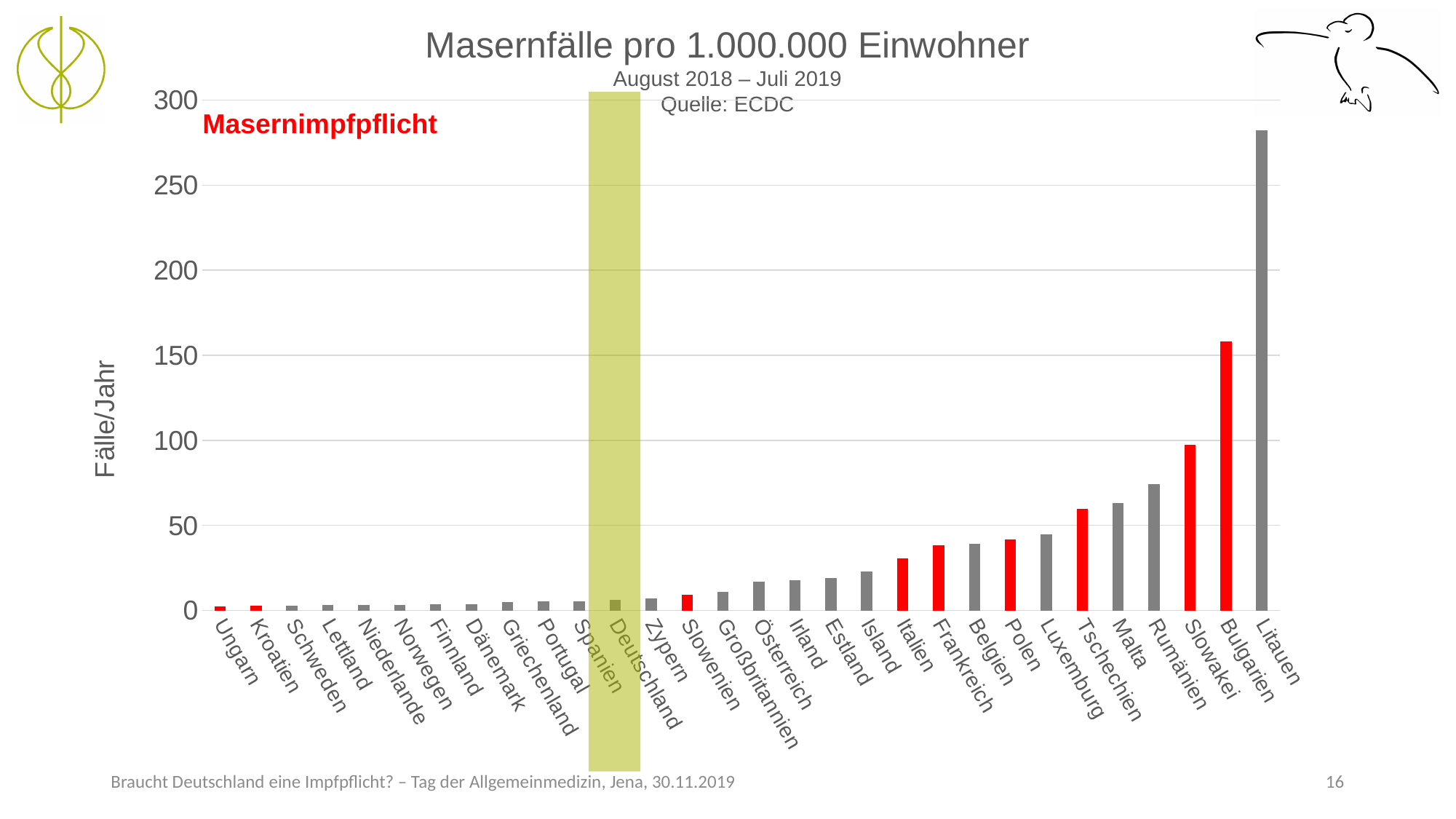
Which country has the highest number of measles cases per 1,000,000 inhabitants? Litauen Is the value for Bulgarien greater or less than 150? greater Do the values rise or fall from left to right along the x axis? rise Is the value for Litauen greater or less than 250? greater Which has the larger value, Bulgarien or Slowakei? Bulgarien Is the value for Rumänien greater or less than 50? greater Which country is highlighted with a yellow-green shaded column in the chart? Deutschland How many countries are shown on the x axis of the chart? 30 What kind of chart is shown on the slide? bar chart Which has the larger value, Rumänien or Malta? Rumänien